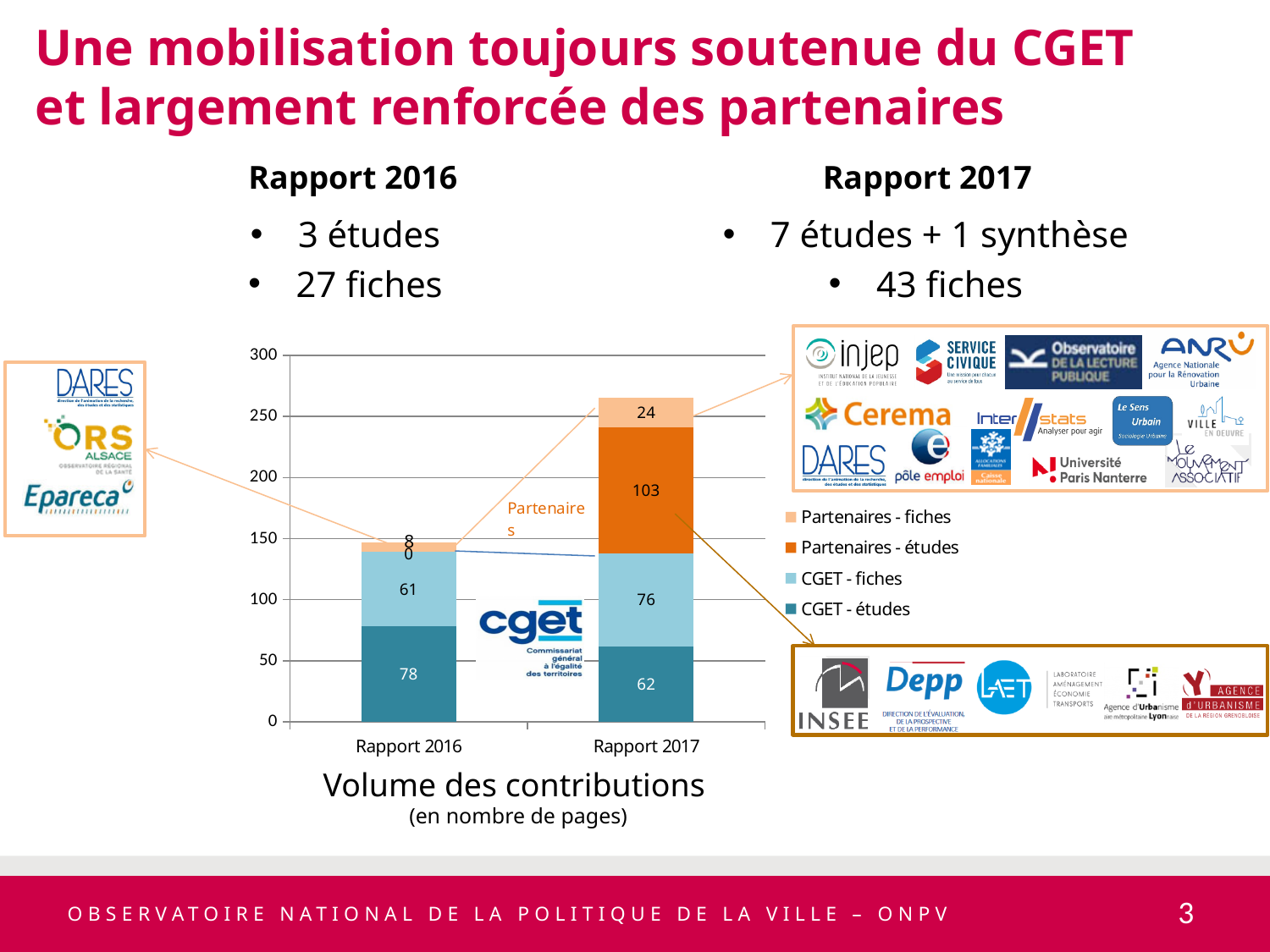
What kind of chart is shown on the slide? bar chart What is the value of Partenaires - études for Rapport 2017? 103 What is the value of Partenaires - fiches for Rapport 2017? 24 Is the total of the Rapport 2016 bar greater or less than 200? less How many series does the chart legend list? 4 What is the total of the stacked bar for Rapport 2017? 265 What is the difference between CGET - études for Rapport 2016 and for Rapport 2017? 16 Which series has the largest segment in the Rapport 2017 bar? Partenaires - études How many categories are shown on the x axis of the chart? 2 What is the value of CGET - fiches for Rapport 2017? 76 What is the value of CGET - études for Rapport 2016? 78 Is CGET - fiches larger for Rapport 2016 or for Rapport 2017? Rapport 2017